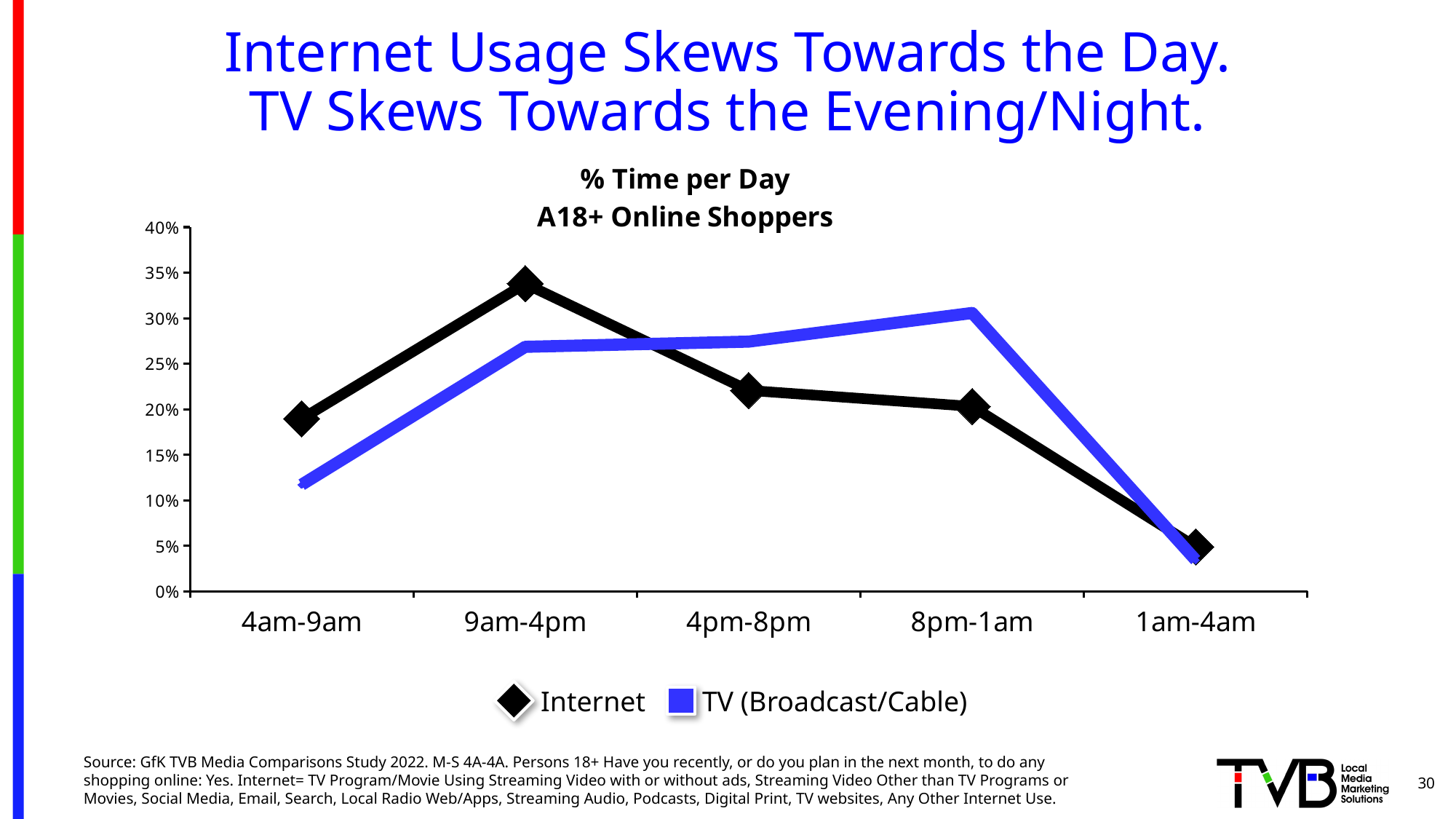
Is the TV (Broadcast/Cable) value for 4am-9am greater or less than 15%? less Is the Internet value for 9am-4pm greater or less than 30%? greater Which series has the larger value in the 8pm-1am period, Internet or TV (Broadcast/Cable)? TV (Broadcast/Cable) What is the title of the chart? % Time per Day A18+ Online Shoppers In which time period is the Internet series at its highest? 9am-4pm In which time period is the TV (Broadcast/Cable) series at its lowest? 1am-4am In which time period is the Internet series at its lowest? 1am-4am How many series does the legend list? 2 What kind of chart is shown on the slide? line chart Which series has the larger value in the 4am-9am period, Internet or TV (Broadcast/Cable)? Internet In which time period is the TV (Broadcast/Cable) series at its highest? 8pm-1am How many time periods are shown on the x axis? 5